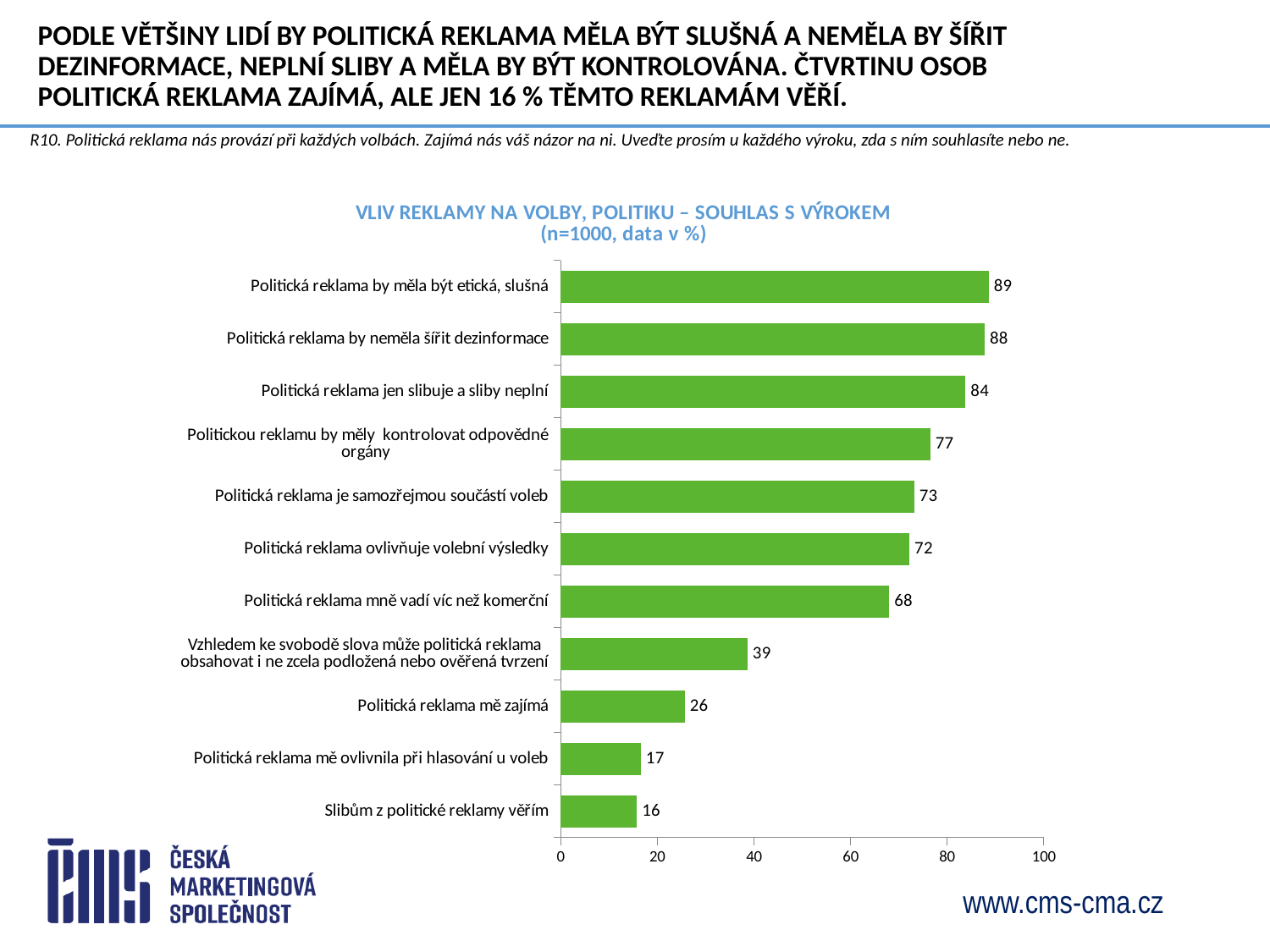
What is the value for "Politická reklama jen slibuje a sliby neplní"? 84 Which is larger: the value for "Politická reklama mně vadí víc než komerční" or the value for "Vzhledem ke svobodě slova může politická reklama obsahovat i ne zcela podložená nebo ověřená tvrzení"? Politická reklama mně vadí víc než komerční How many categories are shown in the chart? 11 What is the value for "Politická reklama by měla být etická, slušná"? 89 What is the difference between the values for "Politická reklama jen slibuje a sliby neplní" and "Politická reklama mě zajímá"? 58 Is the value for "Politickou reklamu by měly kontrolovat odpovědné orgány" greater or less than 60? greater Which category has the lowest value? Slibům z politické reklamy věřím What is the value for "Slibům z politické reklamy věřím"? 16 What kind of chart is shown on the slide? bar chart What is the value for "Politická reklama mě zajímá"? 26 Which category has the highest value? Politická reklama by měla být etická, slušná What is the sample size (n) stated in the chart title? n=1000